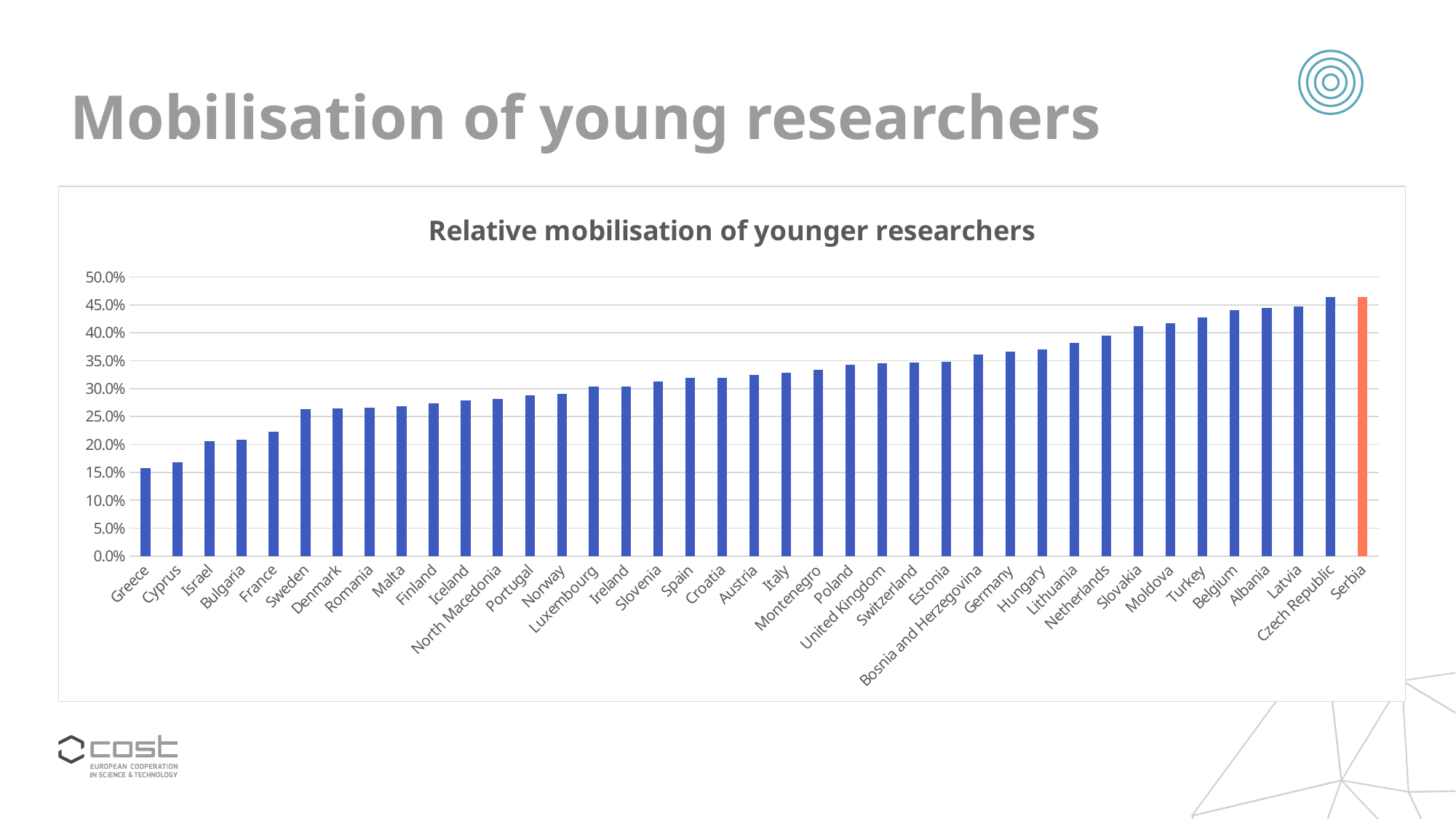
What is the title of the chart? Relative mobilisation of younger researchers How many countries are shown on the x axis of the chart? 39 Which country's bar is shown in a different colour (orange) from the rest? Serbia What kind of chart is shown on the slide? Bar chart Is the value for Poland greater or less than 35.0%? less Is the value for Belgium greater or less than 40.0%? greater Is the value for Sweden greater or less than 25.0%? greater Do the values rise or fall moving from left to right along the x axis? Rise Which has a higher value, Turkey or Sweden? Turkey Which country has the lowest relative mobilisation of younger researchers? Greece